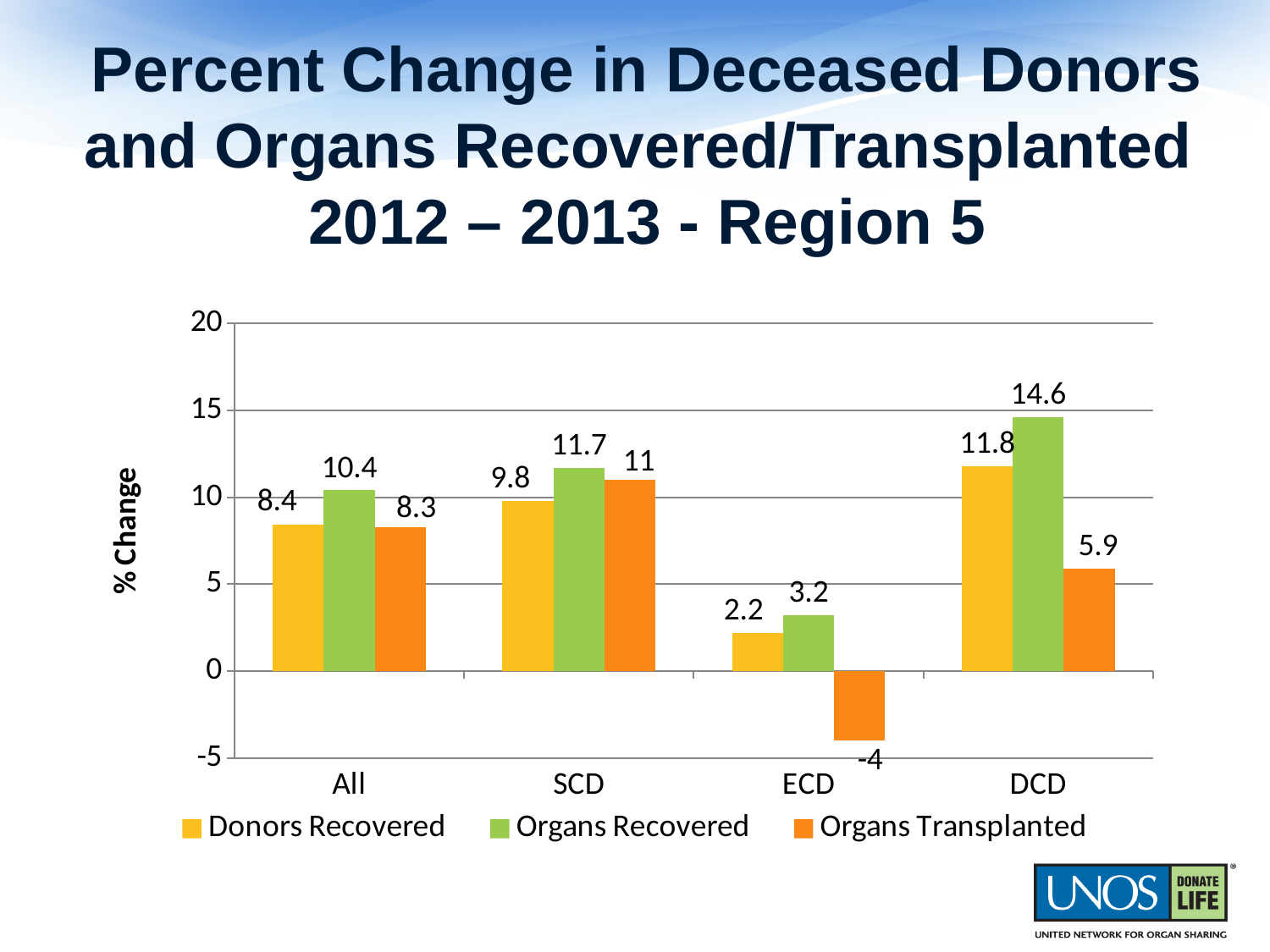
What kind of chart is shown on the slide? bar chart How many series does the legend list? 3 What is the label of the y axis? % Change What is the difference between Organs Recovered and Organs Transplanted in the DCD category? 8.7 What is the value for Donors Recovered in the SCD category? 9.8 Is the value for Donors Recovered in the DCD category greater or less than 10? greater What is the value for Organs Recovered in the DCD category? 14.6 What is the value for Organs Transplanted in the ECD category? -4 Which is larger in the All category: Donors Recovered or Organs Recovered? Organs Recovered Which category has the lowest Organs Transplanted value? ECD How many categories are shown on the x axis? 4 Which category has the highest Organs Recovered value? DCD